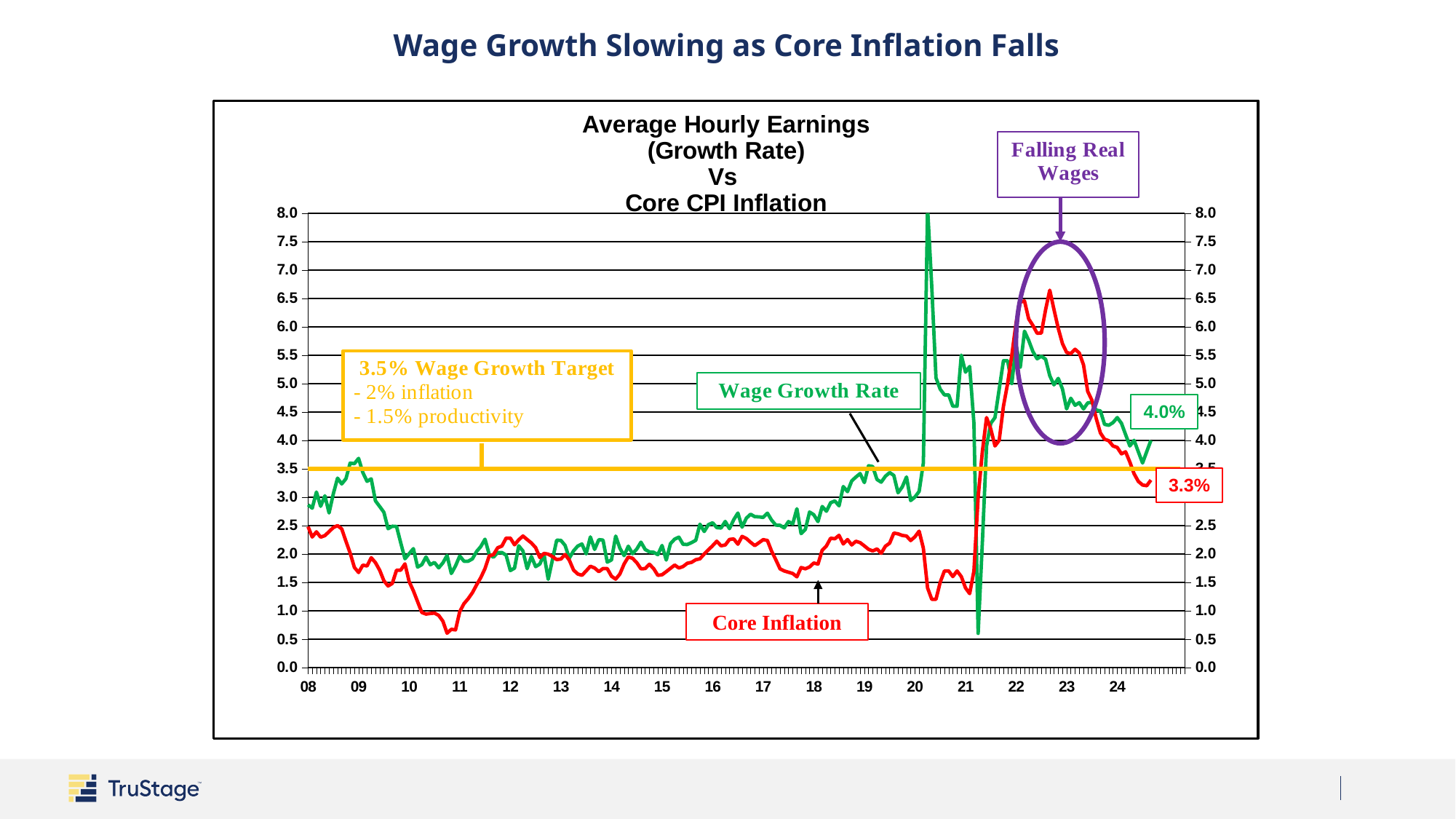
Is the peak of the Wage Growth Rate line around 2020 greater or less than 7.0? greater What is the latest labelled value of the Core Inflation line? 3.3% How many data series (lines) are plotted on the chart, excluding the target line? 2 What value is the horizontal yellow Wage Growth Target line drawn at? 3.5% Is the lowest point of the Core Inflation line around 2010-11 greater or less than 1.0? less What does the purple ellipse on the chart annotate? Falling Real Wages Is the peak of the Core Inflation line around 2022 greater or less than 6.0? greater What is the latest labelled value of the Wage Growth Rate line? 4.0% Does the Wage Growth Rate line rise or fall from 2022 to 2024? fall What kind of chart is shown on the slide? line chart What is the difference between the latest labelled Wage Growth Rate (4.0%) and the latest labelled Core Inflation (3.3%)? 0.7% At the end of the chart, which is larger: the labelled Wage Growth Rate or the labelled Core Inflation? Wage Growth Rate